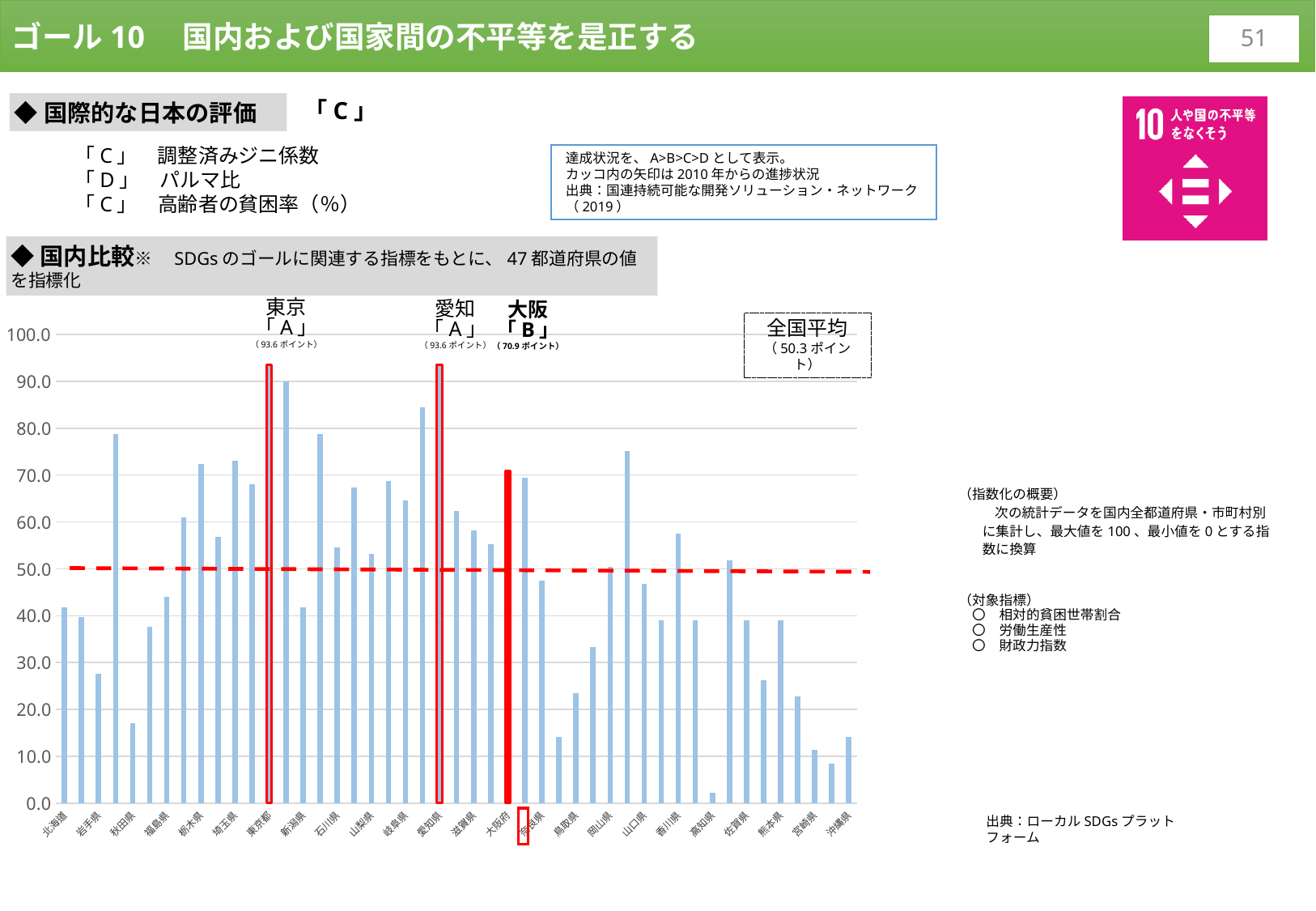
How many prefectures are plotted in the chart? 47 Is the value for 山口県 greater or less than 70? less What is the value shown for 大阪 (Osaka) in the chart? 70.9 ポイント What is the 全国平均 (national average) value shown on the chart? 50.3 ポイント Is the value for 沖縄県 greater or less than 20? less What does the red dashed horizontal line in the chart represent? 全国平均 (50.3 ポイント) How much higher is 大阪 (70.9) than the 全国平均 (50.3)? 20.6 ポイント What kind of chart is used to show the prefecture comparison? bar chart Which has the higher value, 東京 or 大阪? 東京 What is the value shown for 東京 (Tokyo) in the chart? 93.6 ポイント Is the value for 北海道 greater or less than 50? less What is the difference between the values for 東京 (93.6) and 大阪 (70.9)? 22.7 ポイント